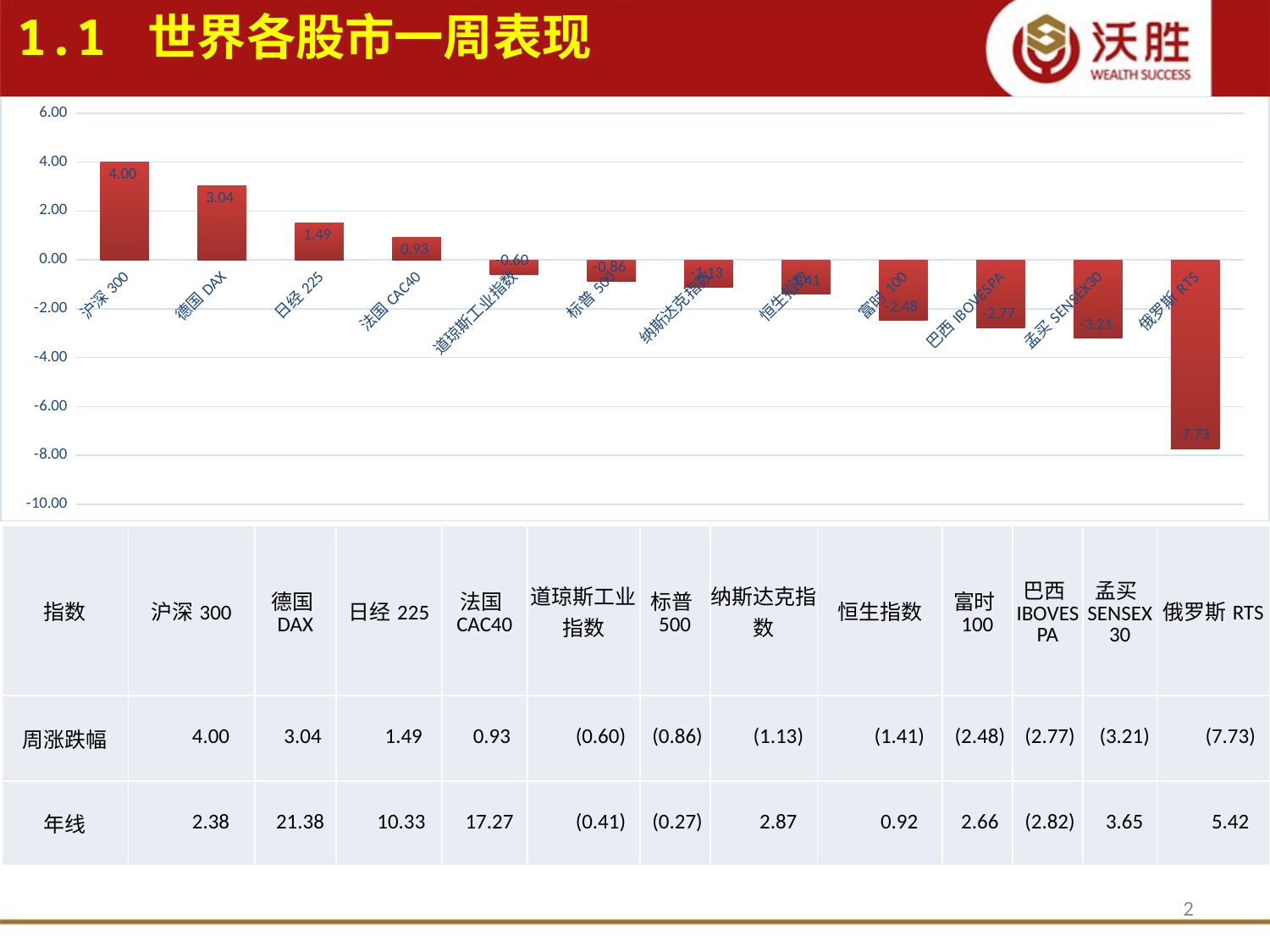
Which is larger, the value for 日经 225 or the value for 法国 CAC40? 日经 225 Which category has the lowest value in the bar chart? 俄罗斯 RTS What is the value for 德国 DAX in the bar chart? 3.04 What is the value for 法国 CAC40 in the bar chart? 0.93 What is the difference between the values for 沪深 300 and 德国 DAX? 0.96 How many categories are plotted in the bar chart? 12 What is the value for 沪深 300 in the bar chart? 4.00 Is the value for 俄罗斯 RTS greater or less than -6.00? less What kind of chart is shown on the slide? bar chart Which category has the highest value in the bar chart? 沪深 300 Do the values rise or fall from left to right along the x axis? fall What is the value for 俄罗斯 RTS in the bar chart? -7.73